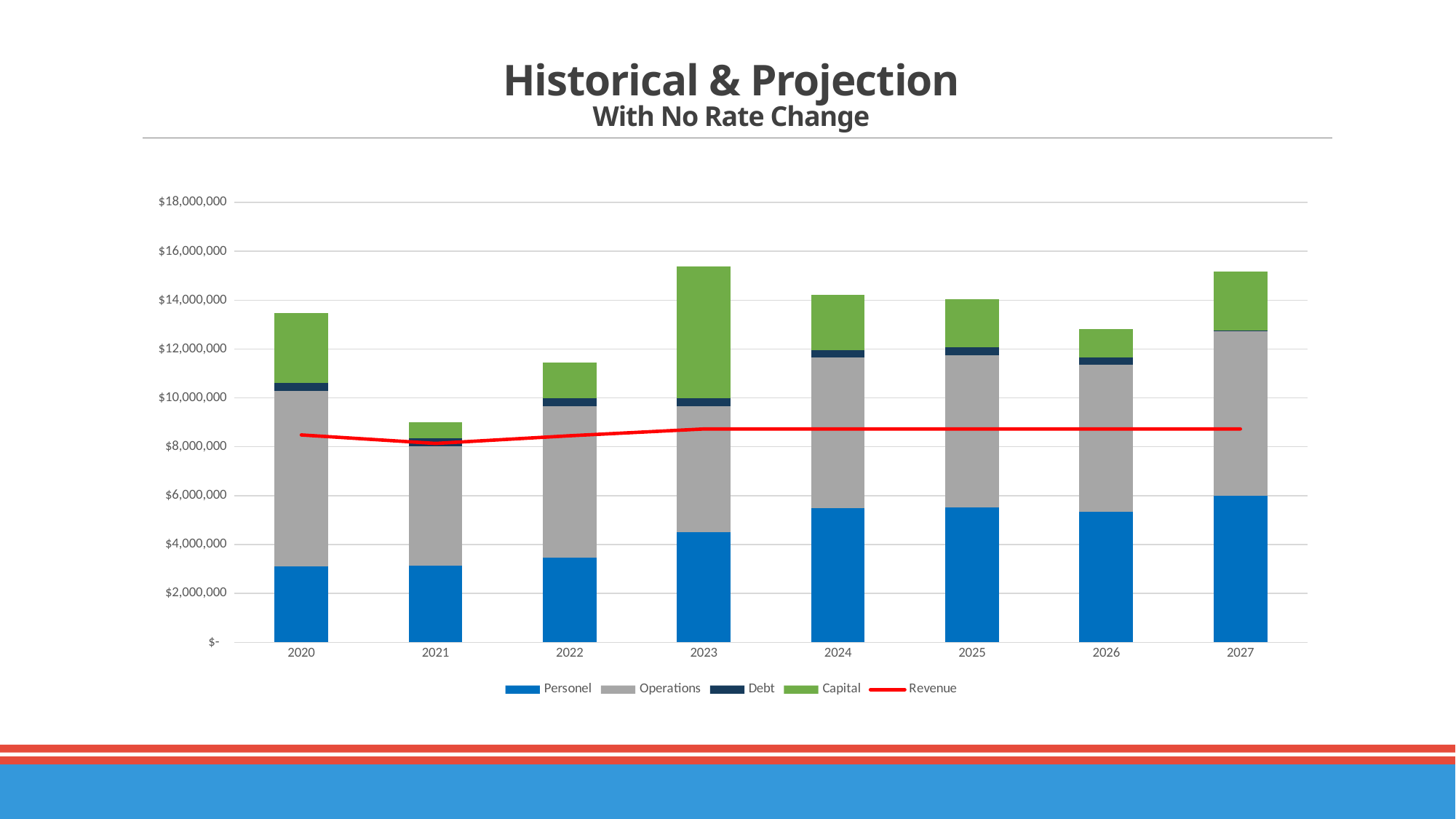
Does the Revenue line rise or fall from 2021 to 2023? rise Which is larger, the total stacked bar for 2022 or for 2023? 2023 Which series is drawn as a red line rather than as bars? Revenue Is the total stacked bar for 2021 greater or less than $10,000,000? less Which year has the lowest total stacked bar? 2021 How many series does the chart's legend list? 5 Is the Revenue value for 2027 greater or less than $10,000,000? less Is the total stacked bar for 2023 greater or less than $14,000,000? greater Which year has the largest Personnel segment? 2027 How many years are shown on the x axis of the chart? 8 What kind of chart is shown on the slide? stacked bar chart with a line (combination bar and line chart) Which year has the largest Capital segment? 2023